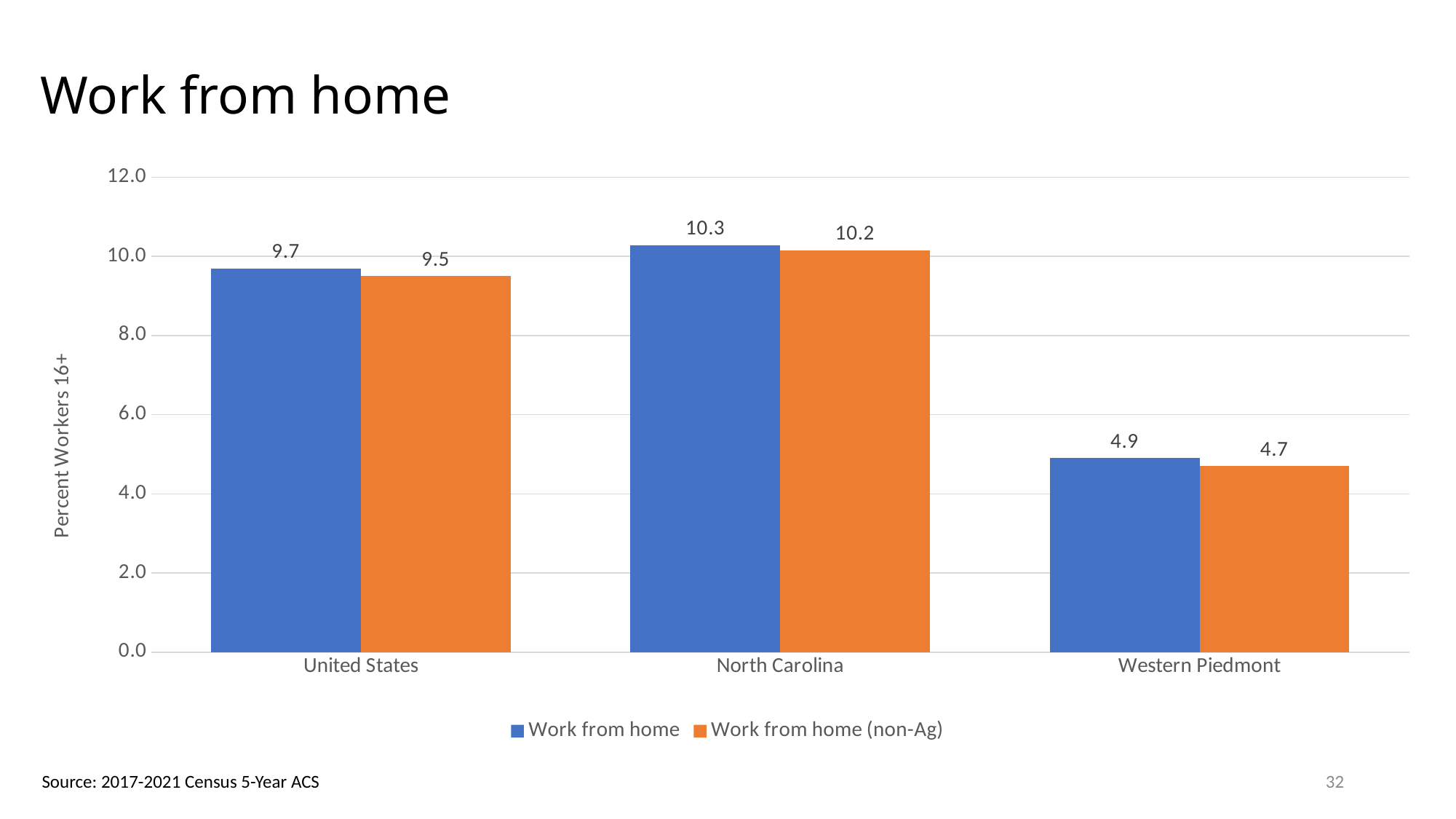
Which region has the lowest Work from home (non-Ag) value? Western Piedmont Is the Work from home value for Western Piedmont greater or less than 6.0? less How many series does the legend list? 2 How many regions are shown on the x axis? 3 What is the Work from home value for North Carolina? 10.3 What is the Work from home (non-Ag) value for United States? 9.5 Which region has the highest Work from home value? North Carolina What is the difference between the Work from home and Work from home (non-Ag) values for United States? 0.2 Which is larger: the Work from home value for United States or for Western Piedmont? United States What kind of chart is shown on the slide? bar chart What is the difference between the Work from home values for North Carolina and Western Piedmont? 5.4 What is the Work from home (non-Ag) value for Western Piedmont? 4.7